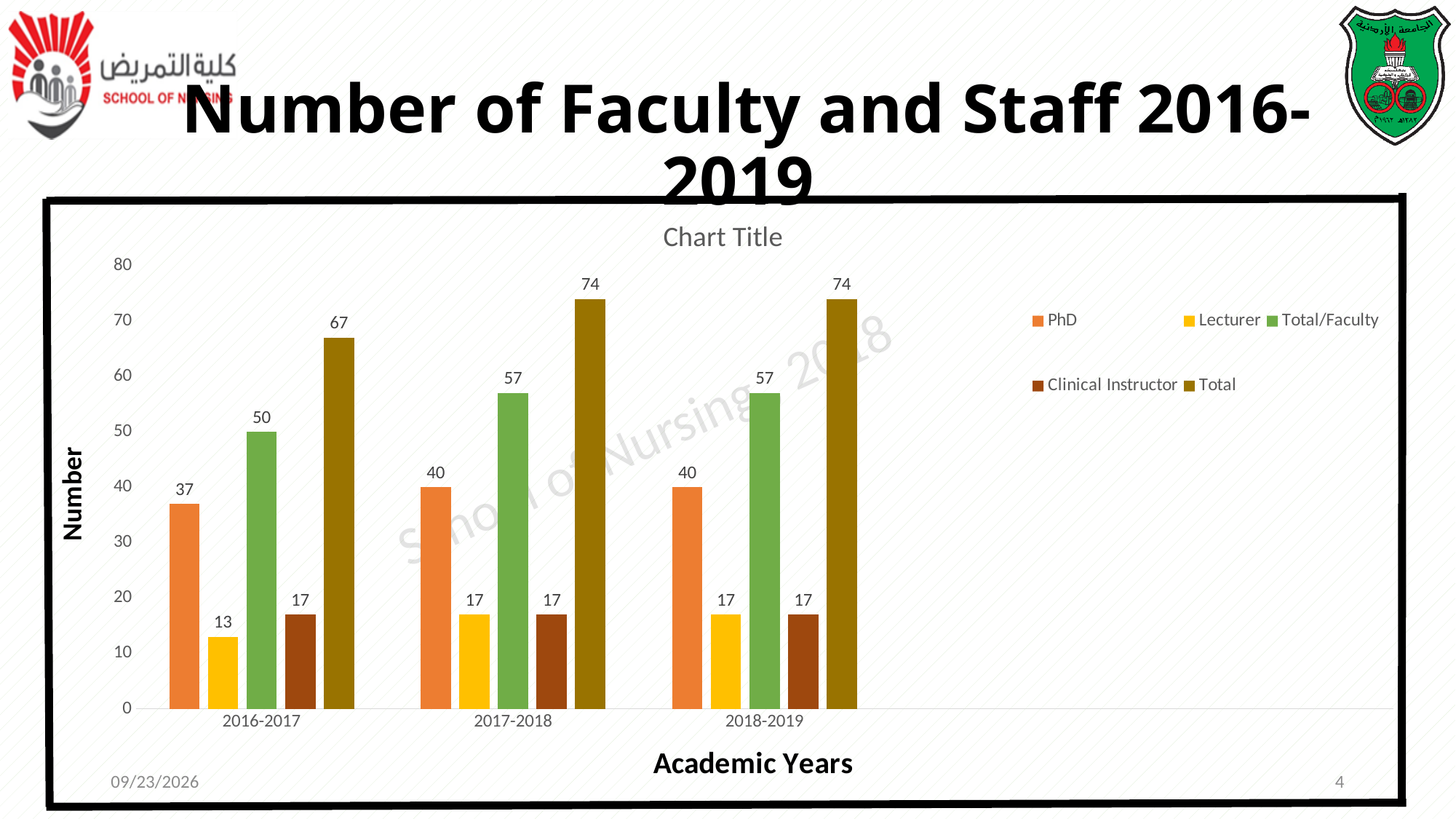
What kind of chart is shown on the slide? Bar chart What is the Lecturer value for 2016-2017? 13 What is the PhD value for 2016-2017? 37 Does the Total/Faculty value rise or fall from 2016-2017 to 2017-2018? Rise What is the Total value for 2017-2018? 74 Which academic year has the lowest Total value? 2016-2017 How many series does the legend list? 5 What is the Total/Faculty value for 2018-2019? 57 What is the difference between the Total values for 2017-2018 and 2016-2017? 7 What is the label of the y axis? Number Which is larger, the PhD value for 2017-2018 or the PhD value for 2016-2017? 2017-2018 How many academic years are shown on the x axis? 3